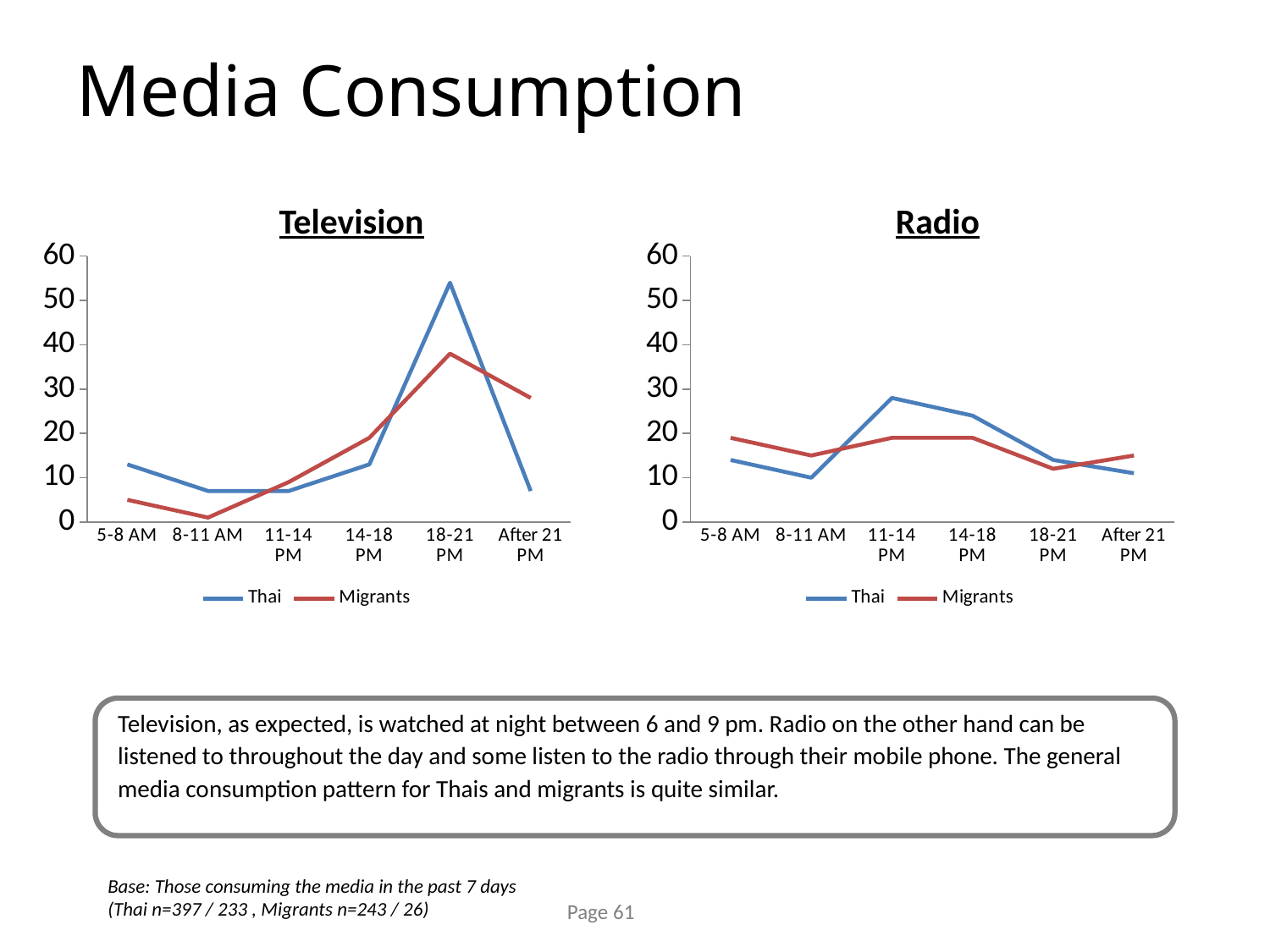
What kind of chart is the Television chart? line chart In the Radio chart, at which time slot does the Thai line reach its highest value? 11-14 PM In the Television chart, is the Thai value at 18-21 PM greater or less than 50? greater In the Television chart, at which time slot is the Migrants line lowest? 8-11 AM How many series does the legend of the Radio chart list? 2 In the Radio chart, is the Thai value at 11-14 PM greater or less than 20? greater In the Television chart, at which time slot does the Thai line reach its highest value? 18-21 PM In the Radio chart, at which time slot is the Thai line lowest? 8-11 AM How many time slots are shown on the x axis of the Television chart? 6 In the Television chart, is the Thai value at After 21 PM greater or less than 10? less In the Television chart, does the Thai line rise or fall from 18-21 PM to After 21 PM? fall In the Television chart, which series has the larger value at After 21 PM, Thai or Migrants? Migrants